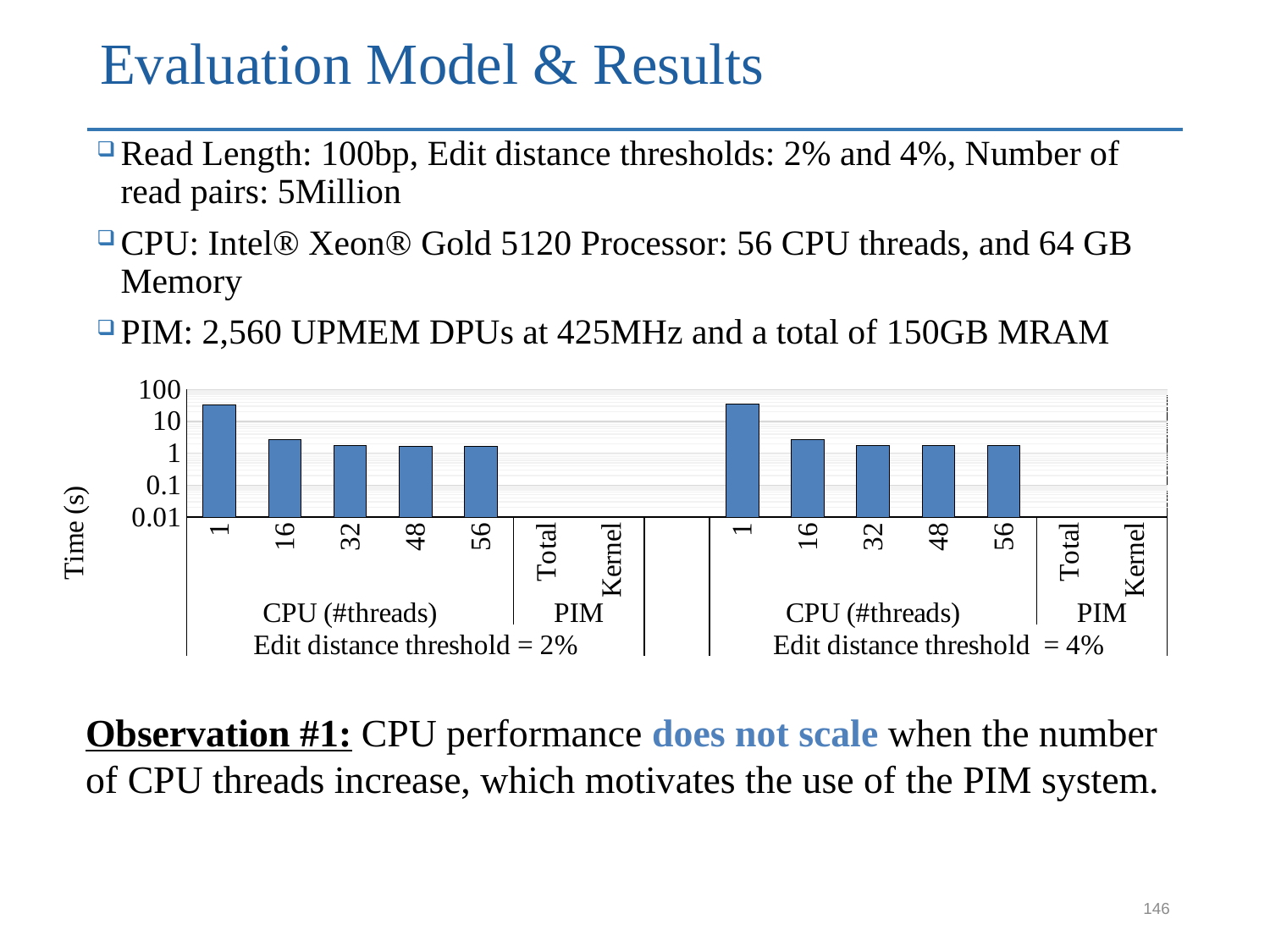
What kind of chart is shown on the slide? bar chart In the Edit distance threshold = 2% group, which CPU thread count has the highest time? 1 In the Edit distance threshold = 4% group, is the time for 56 CPU threads greater or less than 1? greater What is the highest tick value shown on the y axis of the chart? 100 In the Edit distance threshold = 4% group, which CPU thread count has the highest time? 1 In the Edit distance threshold = 2% group, does the CPU time rise or fall as the number of threads increases from 1 to 56? fall What is the label of the y axis of the chart? Time (s) In the Edit distance threshold = 2% group, which has the larger time: 1 CPU thread or 56 CPU threads? 1 CPU thread In the Edit distance threshold = 2% group, is the time for 1 CPU thread greater or less than 10? greater How many CPU thread counts are plotted in each edit distance threshold group? 5 In the Edit distance threshold = 4% group, is the time for 1 CPU thread greater or less than 10? greater